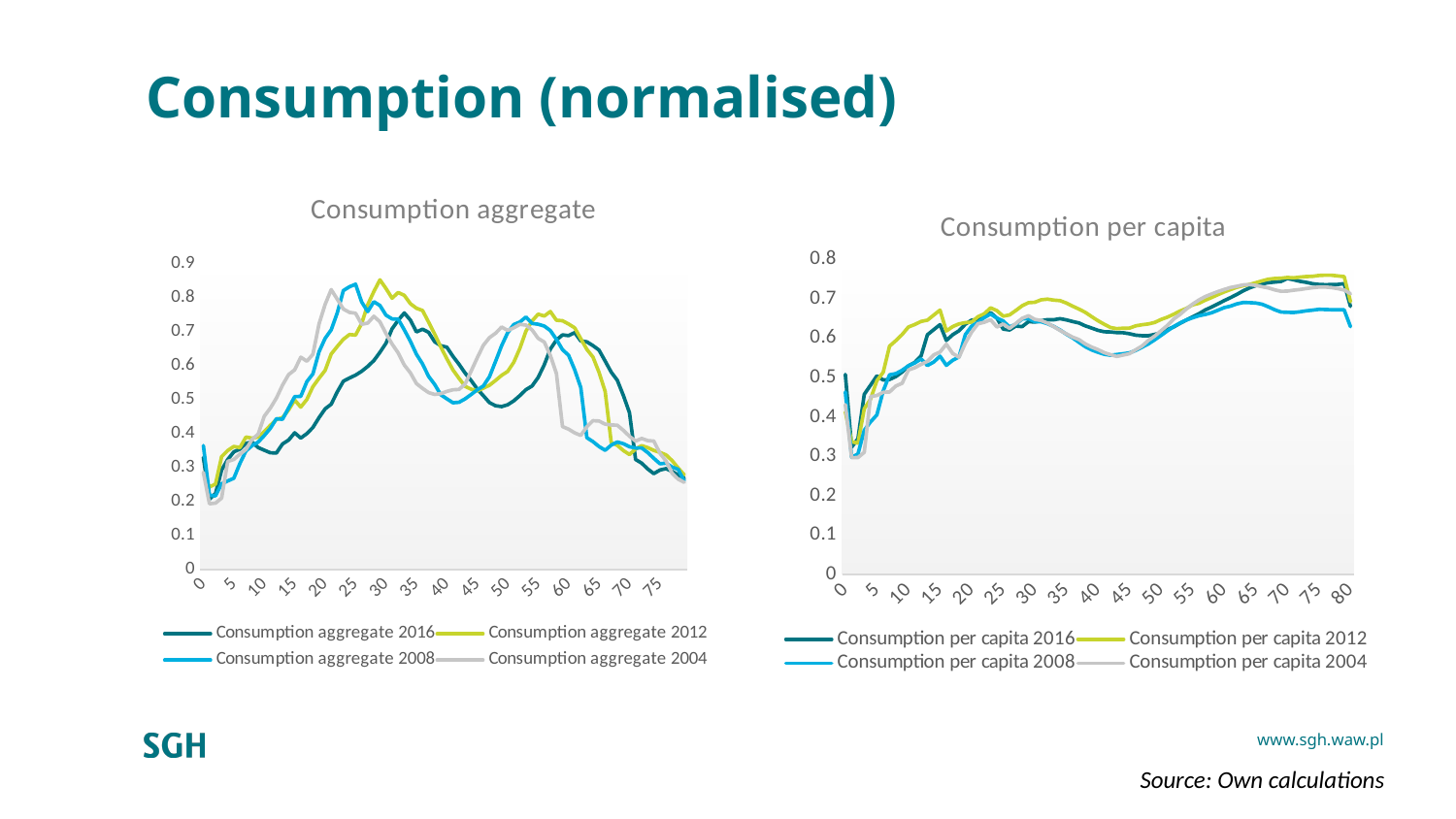
In the 'Consumption per capita' chart, is the value of Consumption per capita 2012 at x = 30 greater or less than 0.6? greater In the 'Consumption aggregate' chart, is the value of Consumption aggregate 2012 at x = 30 greater or less than 0.8? greater In the 'Consumption per capita' chart, does the Consumption per capita 2012 line rise or fall between x = 45 and x = 75? rise In the 'Consumption aggregate' chart, does the Consumption aggregate 2016 line rise or fall between x = 60 and x = 75? fall How many series does the legend of the 'Consumption aggregate' chart list? 4 What kind of chart is the 'Consumption aggregate' chart on the left? line chart In the 'Consumption aggregate' chart, is the value of Consumption aggregate 2016 at x = 30 greater or less than 0.7? less What kind of chart is the 'Consumption per capita' chart on the right? line chart How many series does the legend of the 'Consumption per capita' chart list? 4 What is the title of the chart on the right side of the slide? Consumption per capita